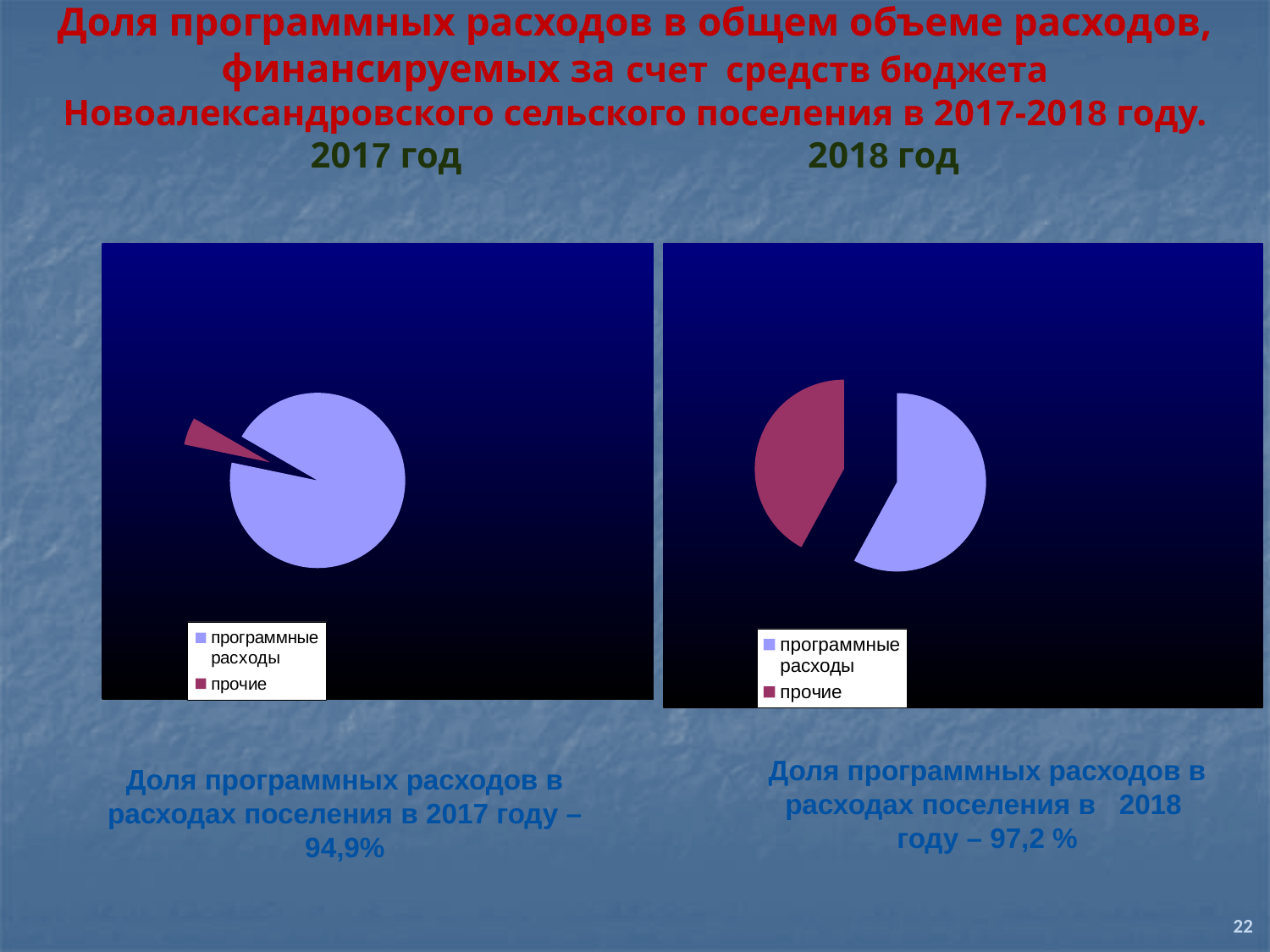
How many slices does the 2017 год pie chart have? 2 In the 2017 год pie chart, which slice is the largest? программные расходы In the 2017 год pie chart, which slice is the smallest? прочие In the 2018 год pie chart, which slice is the smallest? прочие What are the two legend entries of the 2018 год pie chart? программные расходы, прочие How many entries does the legend of the 2017 год chart list? 2 In the 2018 год pie chart, which is larger: программные расходы or прочие? программные расходы What kind of chart is shown for 2018 год? pie chart What colour represents прочие in the 2017 год pie chart? dark red What kind of chart is shown for 2017 год? pie chart In the 2018 год pie chart, which slice is the largest? программные расходы How many slices does the 2018 год pie chart have? 2